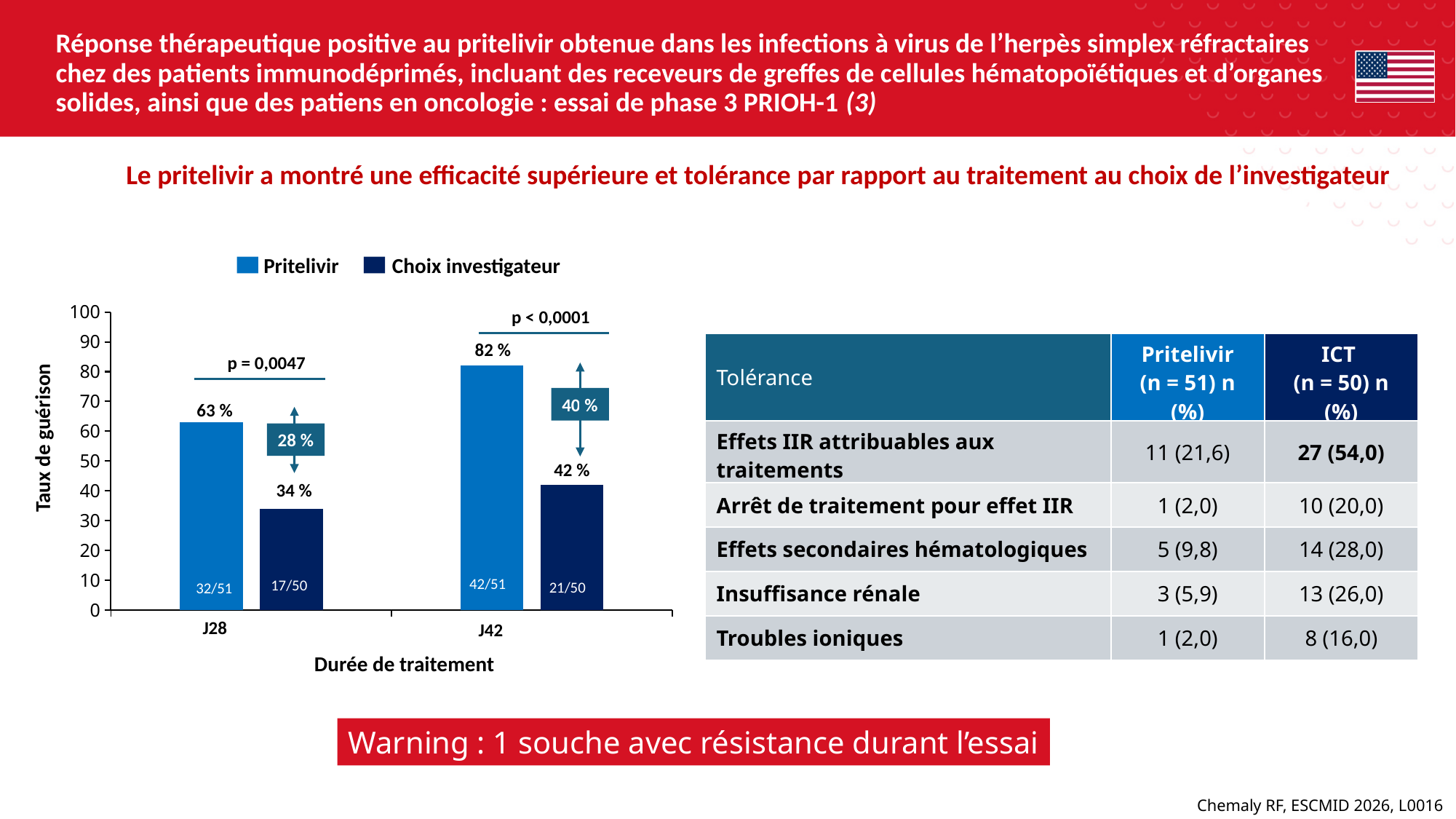
Which bar has the highest cure rate on the chart? Pritelivir at J42 What is the cure rate for Choix investigateur at J42? 42 % What is the cure rate for Choix investigateur at J28? 34 % Which bar has the lowest cure rate on the chart? Choix investigateur at J28 What is the cure rate for Pritelivir at J28? 63 % What is the difference between the Pritelivir and Choix investigateur cure rates at J42? 40 % How many treatment duration categories are shown on the x axis? 2 How many series does the legend list? 2 What p-value is shown above the J28 bars? p = 0,0047 What fraction of patients is shown inside the Pritelivir bar at J42? 42/51 What kind of chart is shown on the slide? Bar chart At J28, which is larger: the Pritelivir cure rate or the Choix investigateur cure rate? Pritelivir